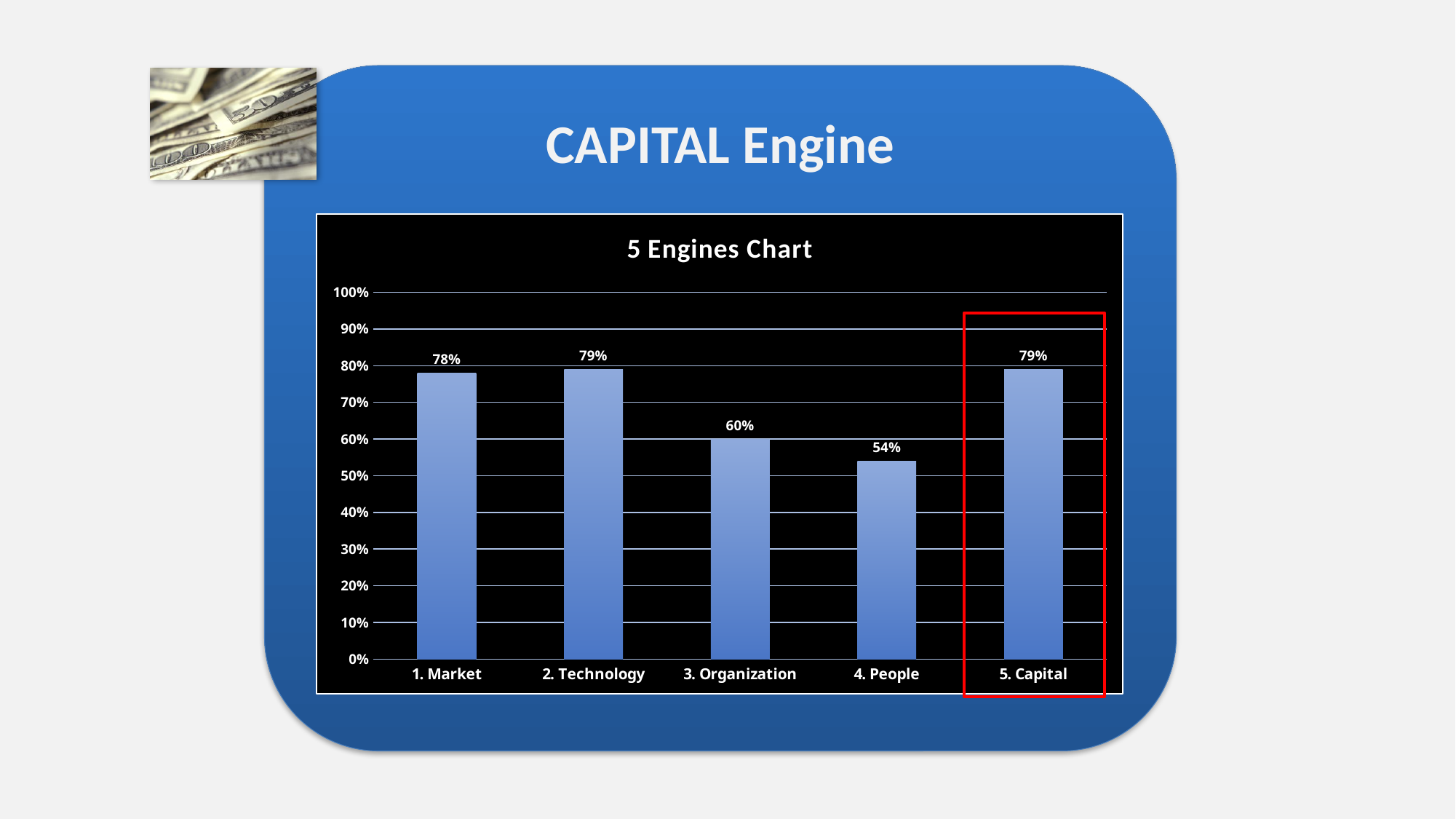
What kind of chart is the 5 Engines Chart? Bar chart Which category is highlighted with a red box in the chart? 5. Capital What is the value for 5. Capital in the 5 Engines Chart? 79% What is the difference between the values for 1. Market and 3. Organization? 18% What is the value for 4. People in the 5 Engines Chart? 54% What is the value for 1. Market in the 5 Engines Chart? 78% How many categories are shown in the 5 Engines Chart? 5 What is the value for 3. Organization in the 5 Engines Chart? 60% Which category has the lowest value in the 5 Engines Chart? 4. People Which is larger, the value for 3. Organization or the value for 4. People? 3. Organization What is the title of the chart on the slide? 5 Engines Chart What is the difference between the values for 2. Technology and 4. People? 25%